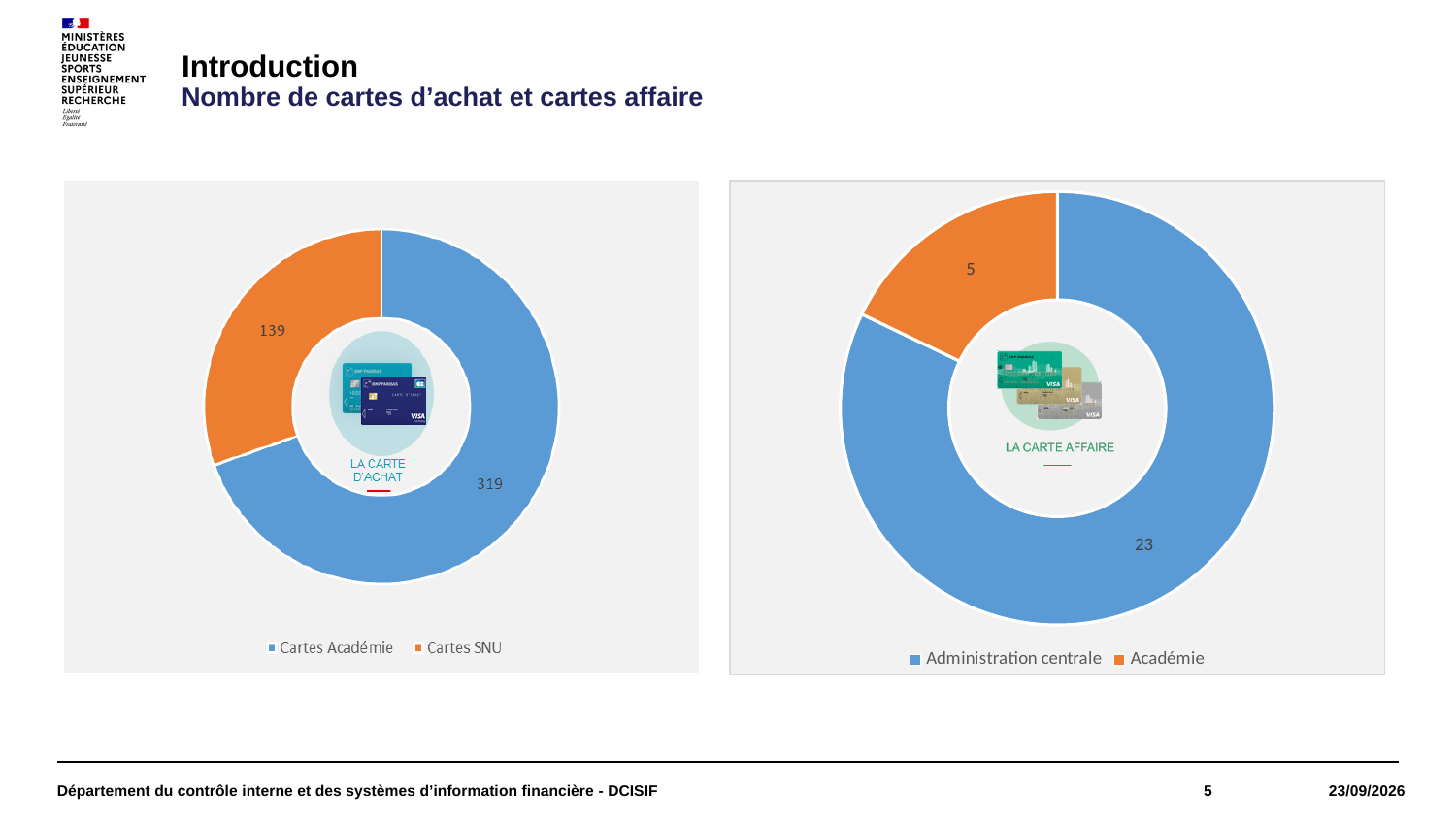
How many categories does the legend of the right chart (La carte affaire) list? 2 In the left chart (La carte d'achat), which category has the largest value? Cartes Académie In the right chart (La carte affaire), what is the total of the two categories? 28 In the right chart (La carte affaire), what is the value for Académie? 5 In the left chart (La carte d'achat), what is the total of the two categories? 458 In the left chart (La carte d'achat), what is the value for Cartes Académie? 319 What kind of chart is the left chart (La carte d'achat)? Doughnut (pie) chart In the right chart (La carte affaire), what is the value for Administration centrale? 23 In the right chart (La carte affaire), what is the difference between Administration centrale and Académie? 18 In the left chart (La carte d'achat), what is the difference between Cartes Académie and Cartes SNU? 180 In the left chart (La carte d'achat), what is the value for Cartes SNU? 139 In the right chart (La carte affaire), which category has the smallest value? Académie